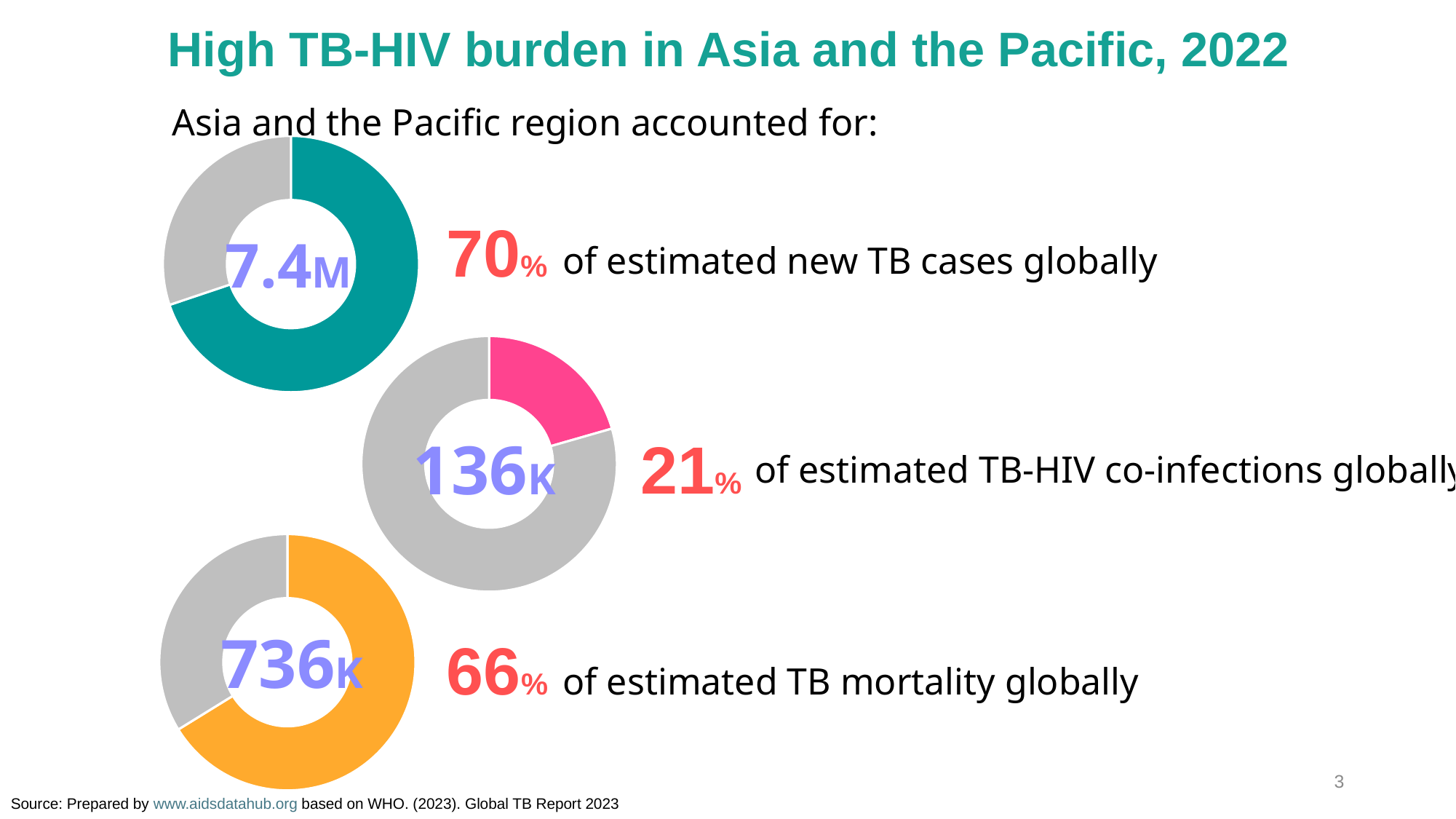
What kind of charts are shown on the slide? Donut (pie) charts What colour is the highlighted slice in the middle donut chart (TB-HIV co-infections)? Pink In the top donut chart, what share of estimated new TB cases globally does Asia and the Pacific account for? 70% How many donut charts are on the slide? 3 In the bottom donut chart, what share of estimated TB mortality globally does Asia and the Pacific account for? 66% In the middle donut chart, what share of estimated TB-HIV co-infections globally does Asia and the Pacific account for? 21% Which of the three donut charts shows the highest percentage share for Asia and the Pacific? New TB cases (70%) What number is printed in the centre of the top donut chart (new TB cases)? 7.4M What is the difference in percentage points between the share of new TB cases (70%) and the share of TB mortality (66%)? 4 percentage points What number is printed in the centre of the bottom donut chart (TB mortality)? 736K Which of the three donut charts shows the lowest percentage share for Asia and the Pacific? TB-HIV co-infections (21%) What number is printed in the centre of the middle donut chart (TB-HIV co-infections)? 136K